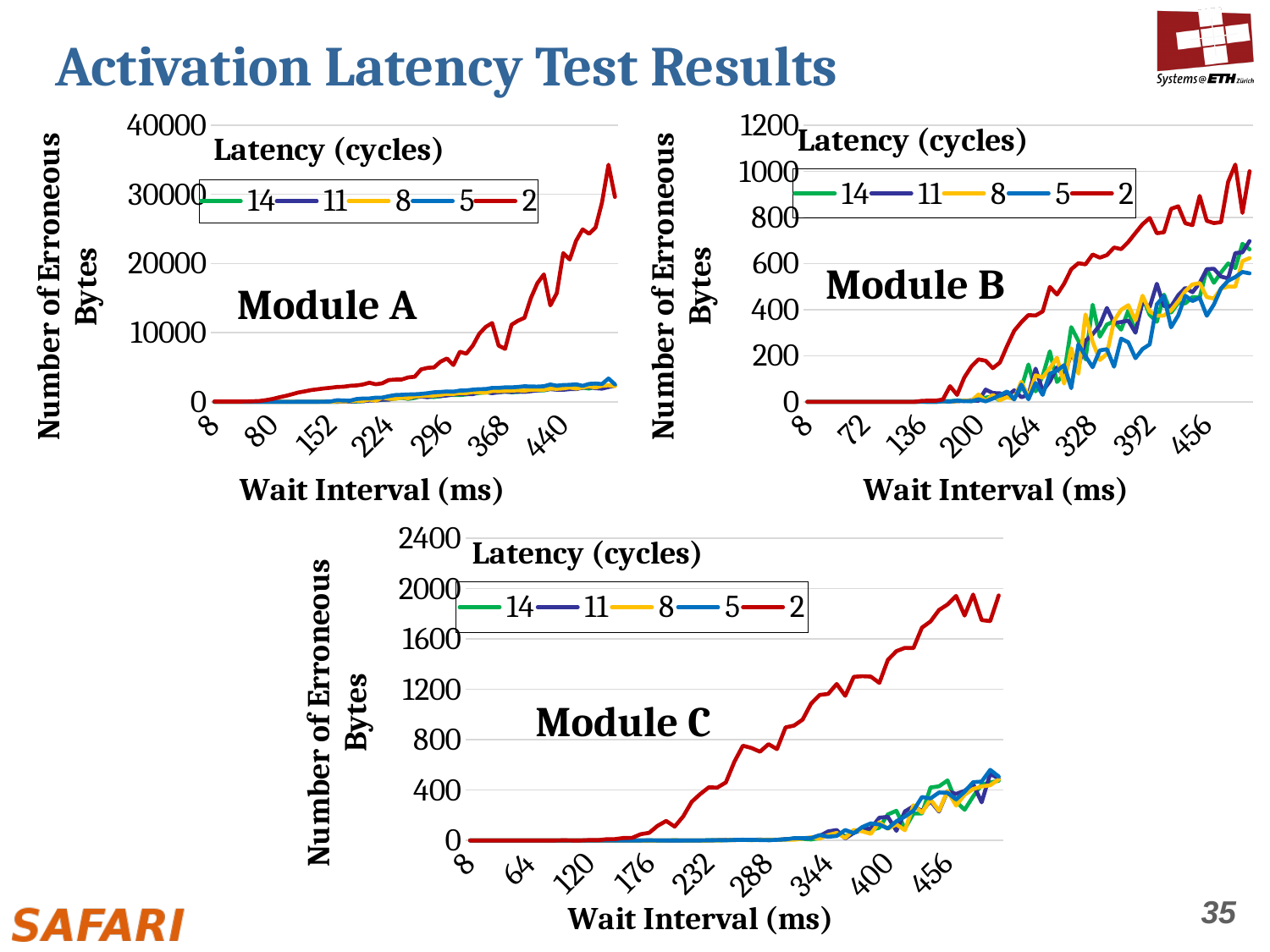
What type of chart is used for Module A? line chart In the Module A chart, which latency series reaches the highest number of erroneous bytes? 2 In the Module C chart, which latency series reaches the highest number of erroneous bytes? 2 In the Module C chart, does the latency 2 series generally rise or fall as the wait interval increases? rise What is the title of the legend on the Module C chart? Latency (cycles) In the Module A chart, at a wait interval of 440 ms, which series has the larger value: latency 2 or latency 5? 2 In the Module C chart, is the peak value of the latency 2 series greater or less than 1600? greater In the Module B chart, is the peak value of the latency 2 series greater or less than 800? greater In the Module B chart, which latency series reaches the highest number of erroneous bytes? 2 How many series does the legend of the Module B chart list? 5 In the Module A chart, is the peak value of the latency 2 series greater or less than 30000? greater What is the x-axis title of the Module A chart? Wait Interval (ms)